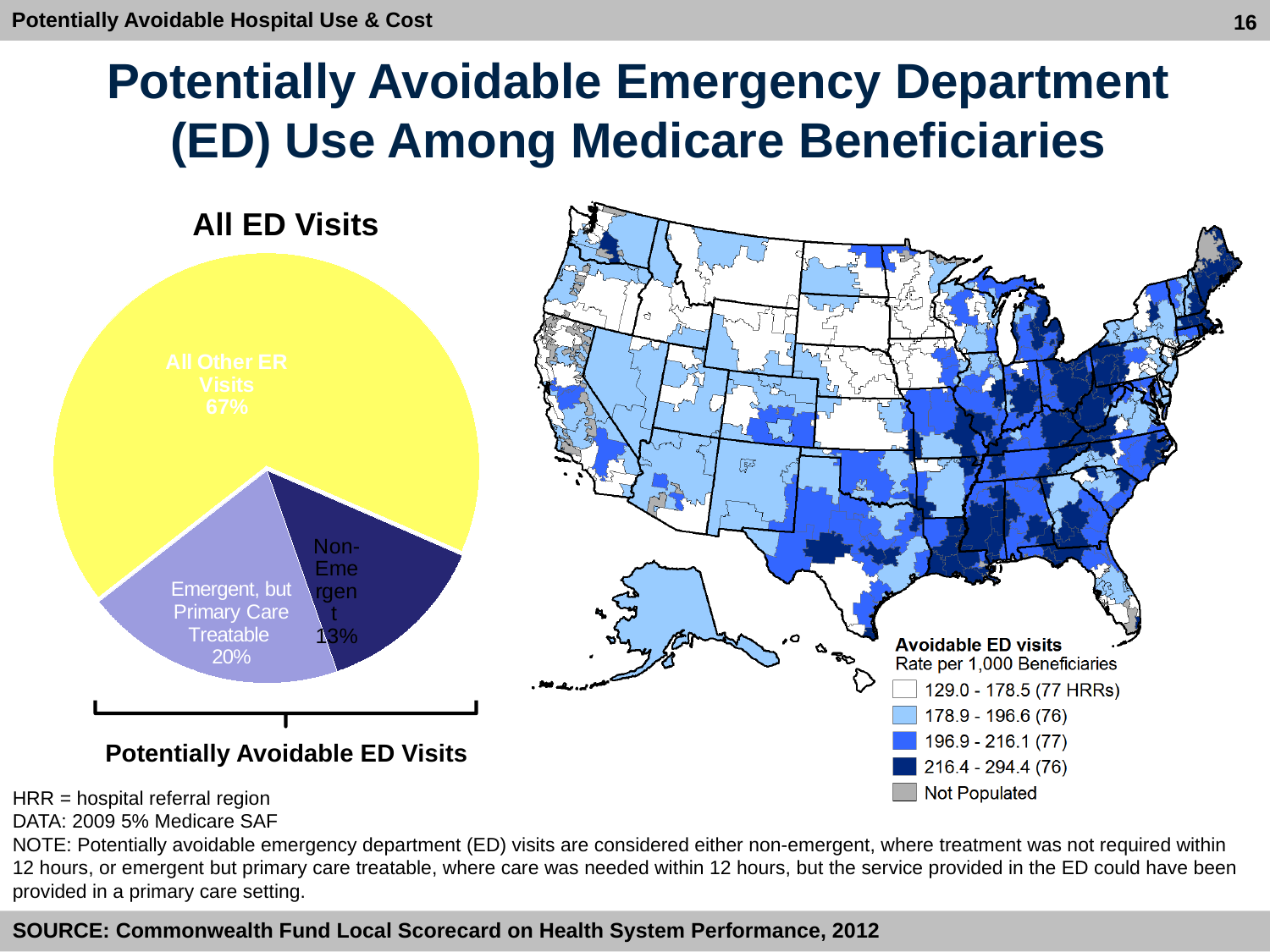
In the "All ED Visits" pie chart, what share of visits is "Non-Emergent"? 13% In the "All ED Visits" pie chart, what share of visits is "All Other ER Visits"? 67% In the "All ED Visits" pie chart, how many slices are there? 3 In the "All ED Visits" pie chart, which slice is the smallest? Non-Emergent In the "All ED Visits" pie chart, which slice is the largest? All Other ER Visits What kind of chart is the "All ED Visits" chart? pie chart In the "All ED Visits" pie chart, what combined share do the two "Potentially Avoidable ED Visits" slices make up? 33% In the "All ED Visits" pie chart, which is larger: "Emergent, but Primary Care Treatable" or "Non-Emergent"? Emergent, but Primary Care Treatable On the map, how many HRRs fall in the 129.0 - 178.5 avoidable ED visit rate category? 77 In the "All ED Visits" pie chart, what colour is the "All Other ER Visits" slice? yellow In the "All ED Visits" pie chart, what is the difference in percentage points between "All Other ER Visits" and "Emergent, but Primary Care Treatable"? 47 percentage points In the "All ED Visits" pie chart, what share of visits is "Emergent, but Primary Care Treatable"? 20%